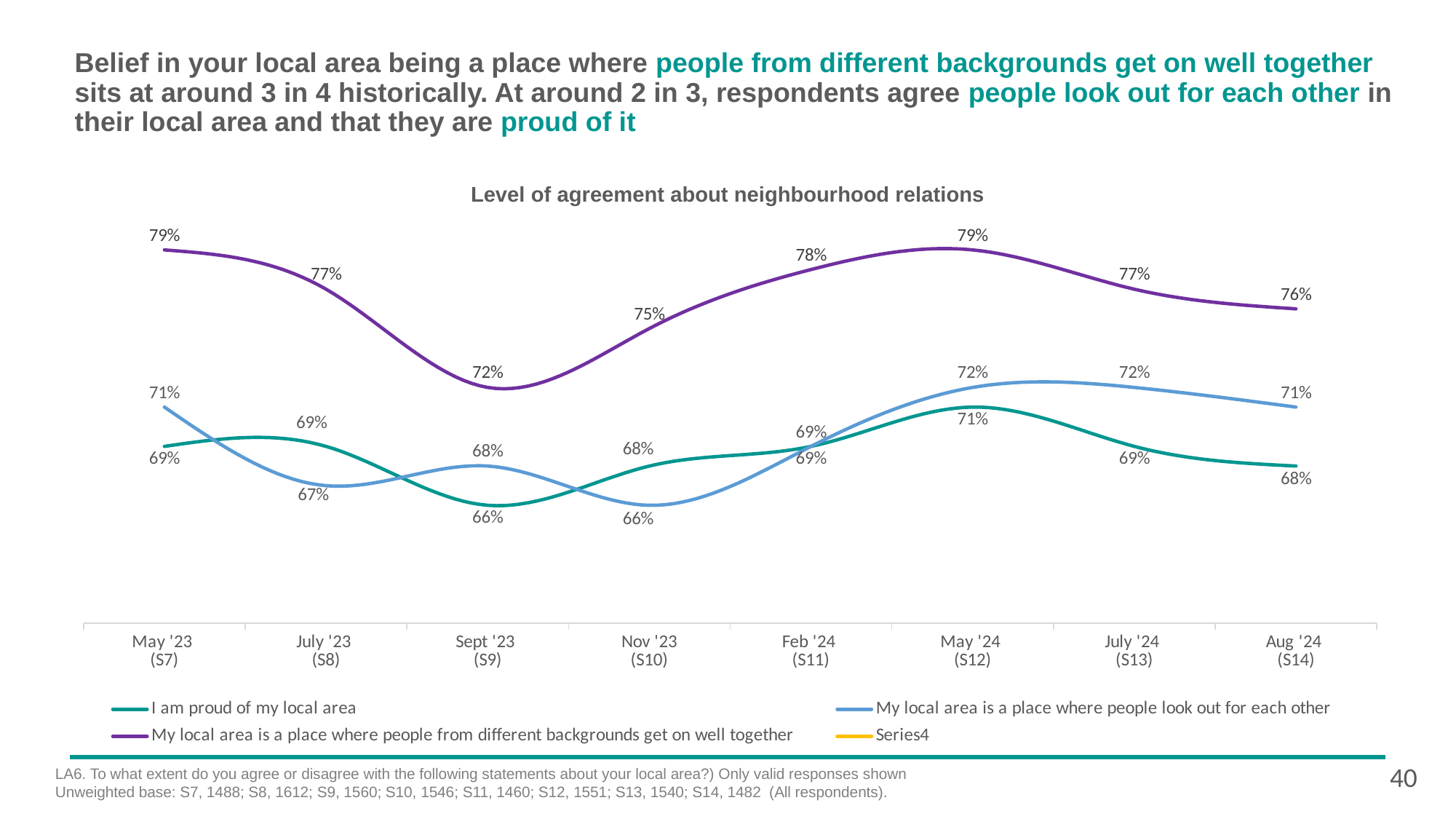
What is the value for 'I am proud of my local area' at May '24 (S12)? 71% What kind of chart is shown? Line chart What is the value for 'My local area is a place where people from different backgrounds get on well together' at Sept '23 (S9)? 72% What is the difference between the May '23 and Sept '23 values for 'My local area is a place where people from different backgrounds get on well together'? 7 percentage points How many time points are shown on the x axis? 8 What is the value for 'My local area is a place where people look out for each other' at Nov '23 (S10)? 66% At which time point is 'My local area is a place where people from different backgrounds get on well together' lowest? Sept '23 (S9) At which time point is 'My local area is a place where people look out for each other' lowest? Nov '23 (S10) What is the title of the chart? Level of agreement about neighbourhood relations At which time point is 'I am proud of my local area' lowest? Sept '23 (S9) At July '23 (S8), which is higher: 'I am proud of my local area' or 'My local area is a place where people look out for each other'? I am proud of my local area Does 'My local area is a place where people from different backgrounds get on well together' rise or fall from Sept '23 to May '24? Rise